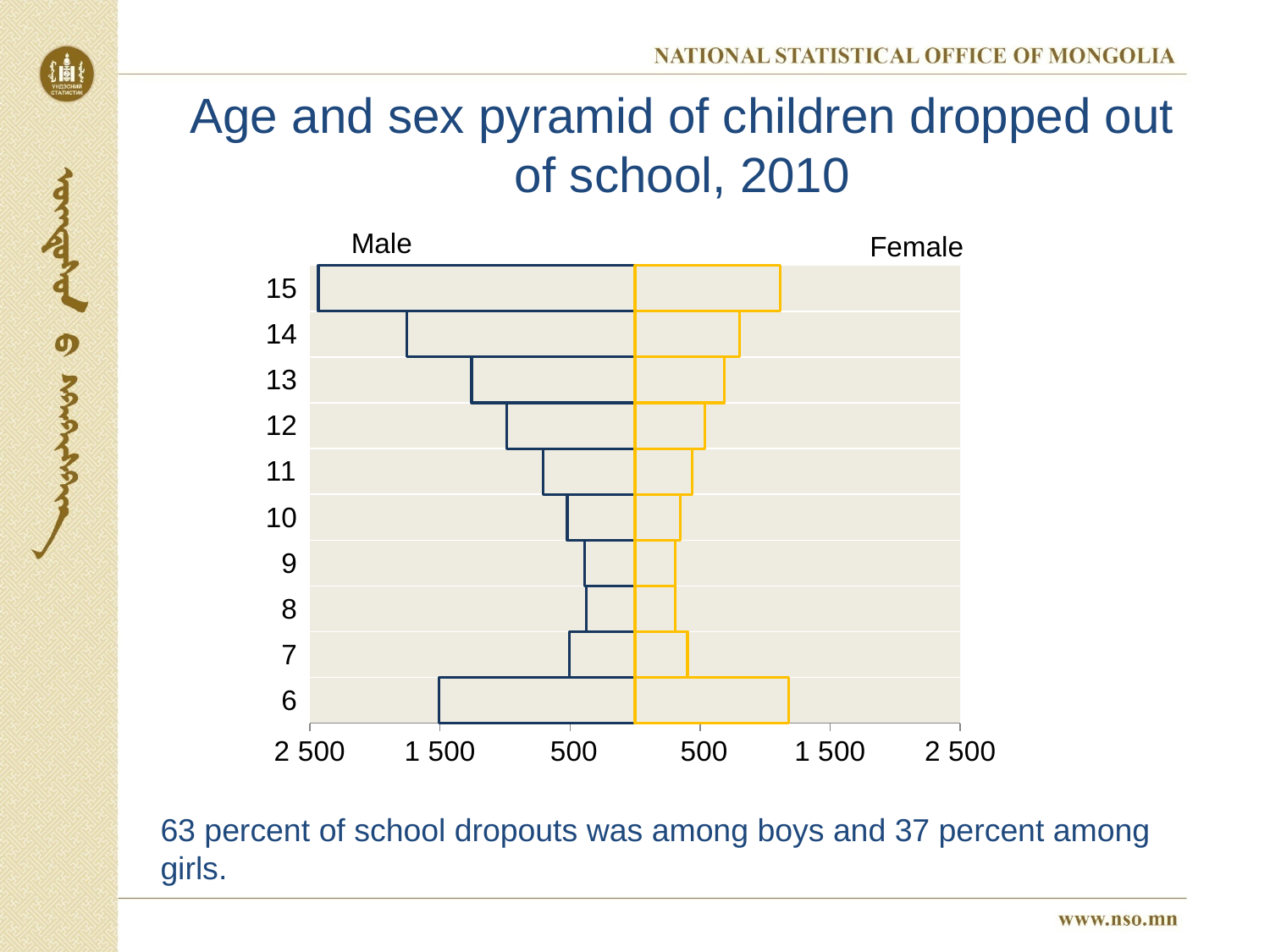
Which is larger, the Male value for age 14 or the Male value for age 13? age 14 Is the Female value for age 9 greater or less than 500? less Is the Male value for age 9 greater or less than 500? less What is the title of the chart? Age and sex pyramid of children dropped out of school, 2010 Which age has the highest Male value? 15 What kind of chart is shown on the slide? bar chart Is the Female value for age 15 greater or less than 500? greater How many age groups are shown on the chart? 10 How many series does the chart show? 2 Do the Male values rise or fall as age increases from 9 to 15? rise For age 15, which is larger, the Male value or the Female value? Male